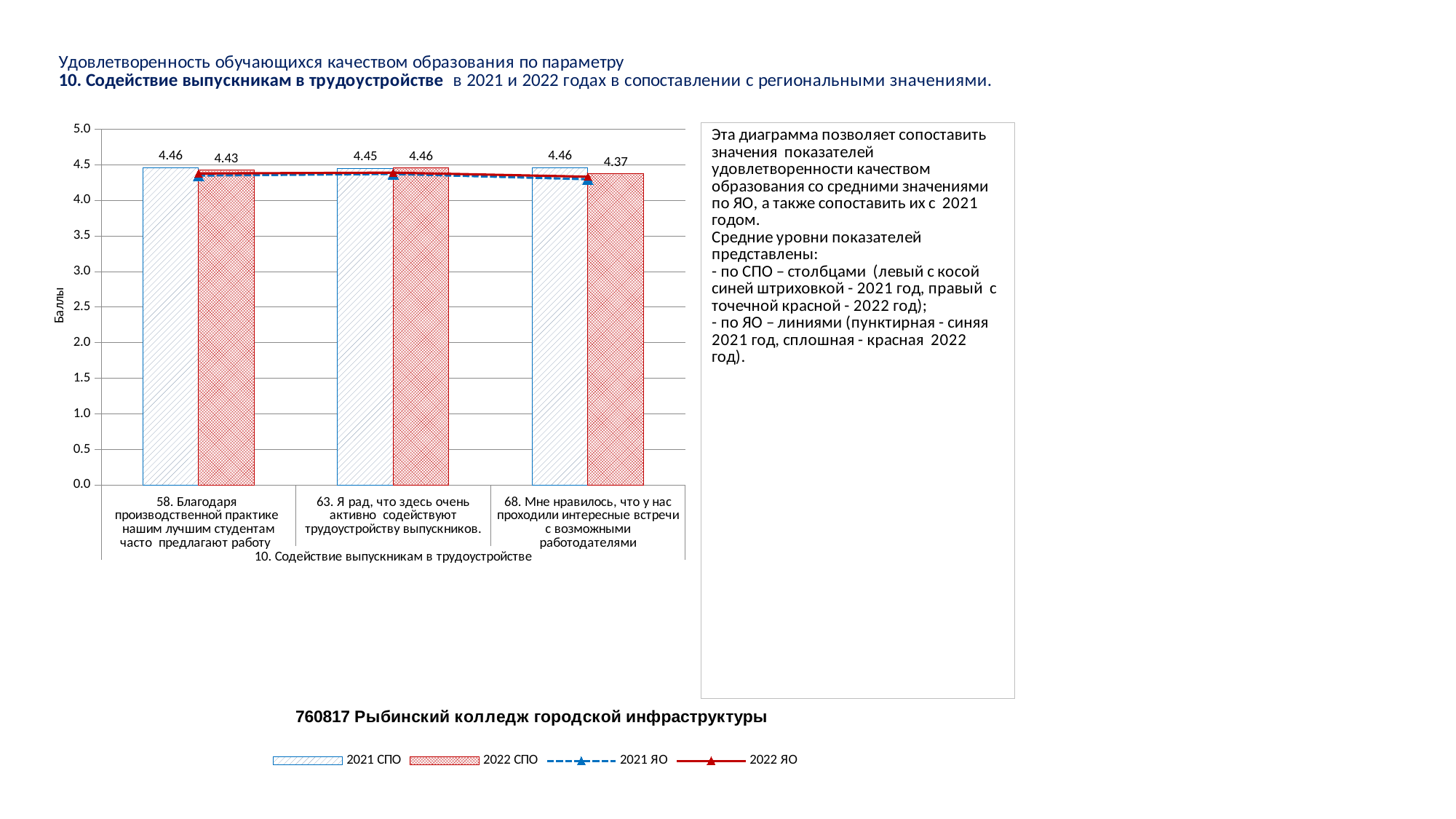
What is the value of the 2022 СПО bar for category 68 (Мне нравилось, что у нас проходили интересные встречи с возможными работодателями)? 4.37 Which category has the lowest 2022 СПО value? 68. Мне нравилось, что у нас проходили интересные встречи с возможными работодателями What is the value of the 2022 СПО bar for category 58? 4.43 What kind of chart is used to show the СПО values? bar chart What is the value of the 2021 СПО bar for category 58 (Благодаря производственной практике нашим лучшим студентам часто предлагают работу)? 4.46 What is the value of the 2021 СПО bar for category 63 (Я рад, что здесь очень активно содействуют трудоустройству выпускников)? 4.45 What is the difference between the 2021 СПО and 2022 СПО values for category 68? 0.09 Is the 2021 ЯО line value for category 58 greater or less than 4.0? greater What is the title of the y axis? Баллы How many series does the legend list? 4 For category 58, which is larger: the 2021 СПО value or the 2022 СПО value? 2021 СПО How many categories are shown on the x axis? 3